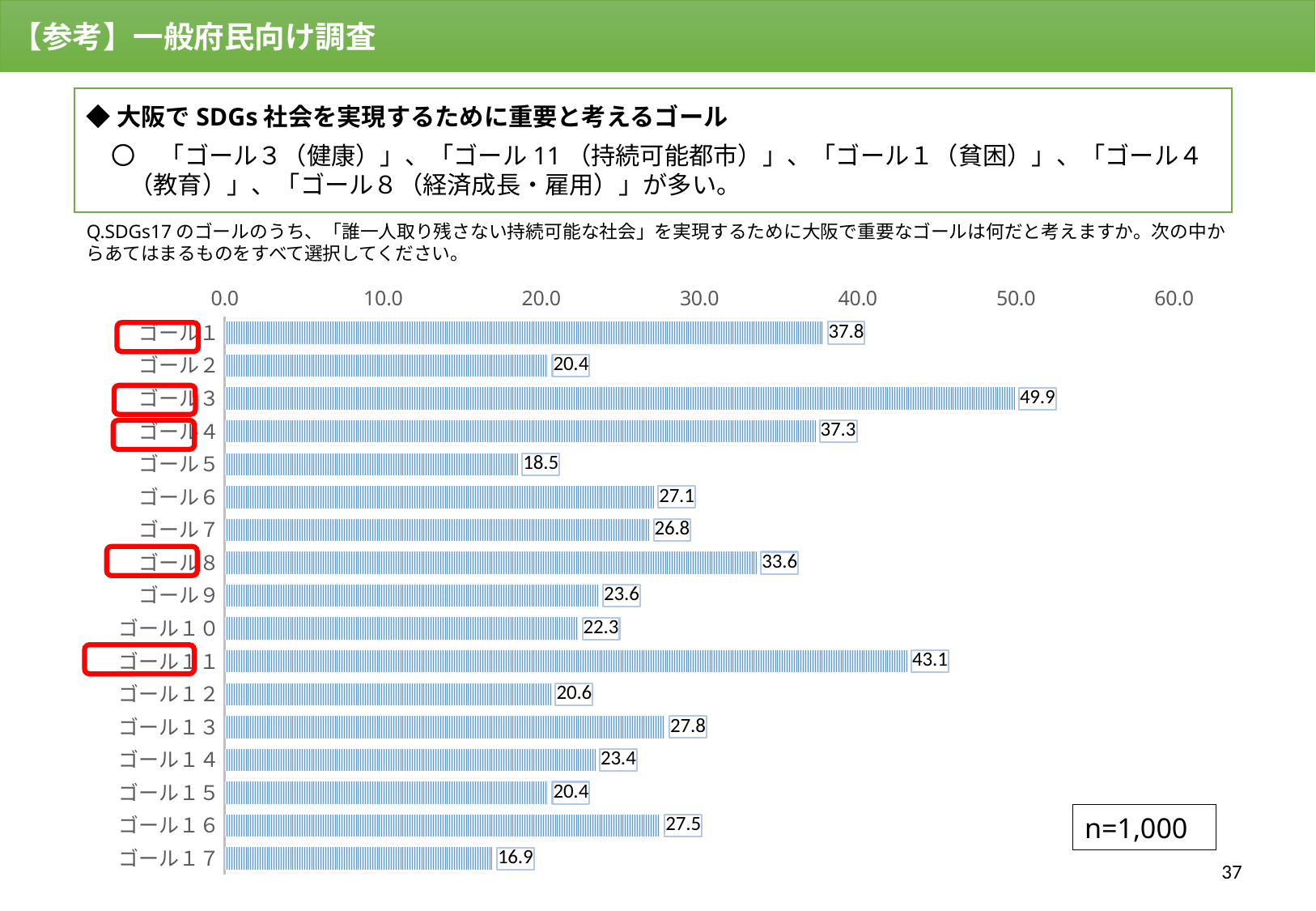
What is the value for ゴール１７? 16.9 What is the value for ゴール１１? 43.1 What is the value for ゴール３? 49.9 What is the difference between the values for ゴール１ and ゴール１７? 20.9 Is the value for ゴール８ greater or less than 30.0? greater Which is larger, the value for ゴール１ or the value for ゴール４? ゴール１ What is the difference between the values for ゴール３ and ゴール１１? 6.8 How many goals (categories) are shown in the chart? 17 What kind of chart is shown on the slide? bar chart Which goal has the lowest value? ゴール１７ Which goal has the highest value? ゴール３ What sample size (n) is shown on the slide? n=1,000